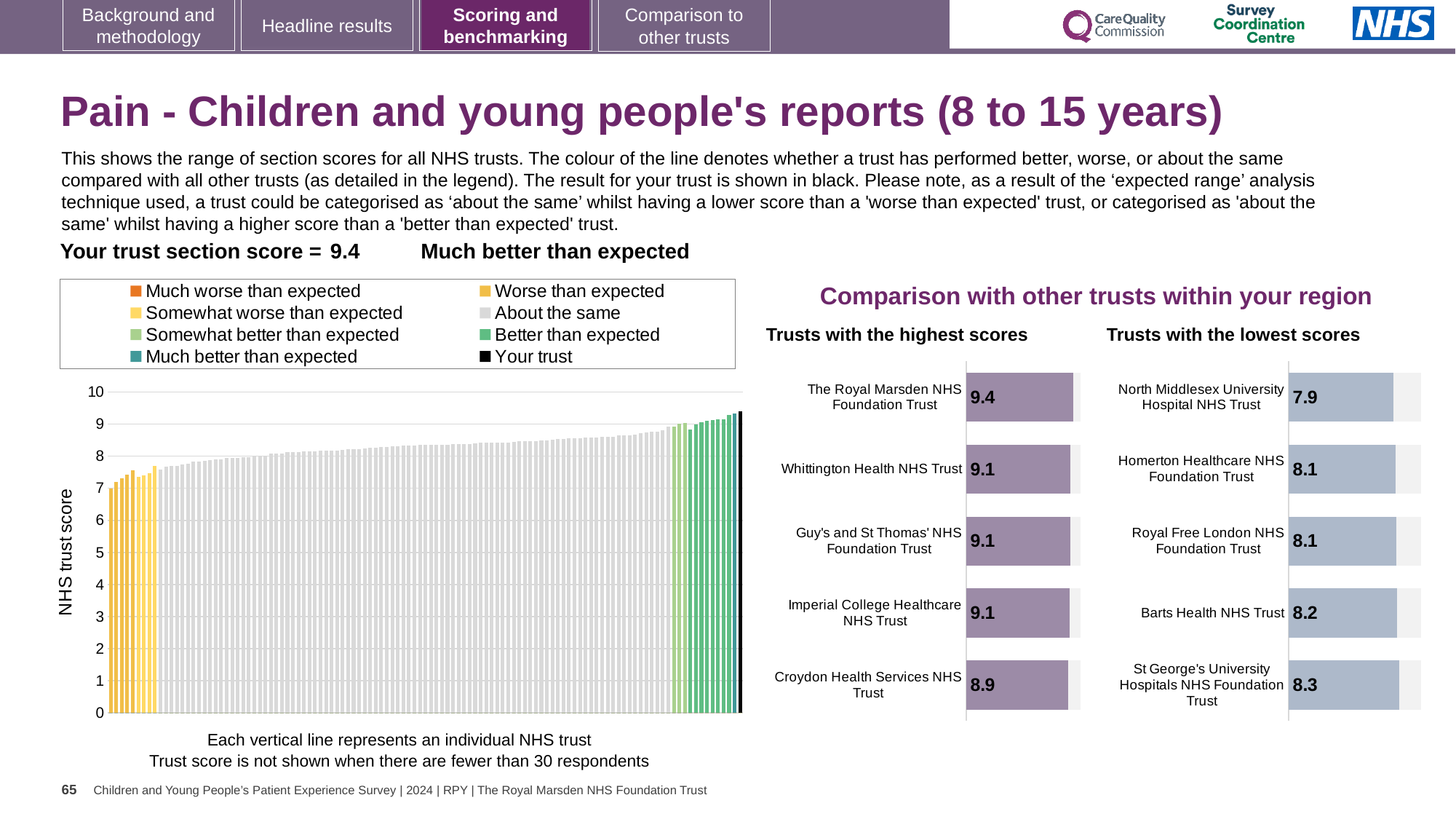
In the 'Trusts with the highest scores' chart, what is the difference between the scores of The Royal Marsden NHS Foundation Trust and Croydon Health Services NHS Trust? 0.5 In the left-hand NHS trust score chart, do the bars rise or fall from left to right? Rise In the left-hand NHS trust score chart, is the value of the leftmost bar greater or less than 5? greater In the 'Trusts with the lowest scores' chart, which trust has the lowest score? North Middlesex University Hospital NHS Trust How many entries does the legend of the left-hand NHS trust score chart list? 8 How many trusts are listed in the 'Trusts with the highest scores' chart? 5 In the 'Trusts with the highest scores' chart, what is the score for The Royal Marsden NHS Foundation Trust? 9.4 What kind of chart is the left-hand chart showing NHS trust scores? Bar chart In the 'Trusts with the lowest scores' chart, what is the score for North Middlesex University Hospital NHS Trust? 7.9 In the 'Trusts with the highest scores' chart, what is the score for Croydon Health Services NHS Trust? 8.9 In the 'Trusts with the lowest scores' chart, which trust has the highest score? St George's University Hospitals NHS Foundation Trust In the 'Trusts with the lowest scores' chart, which has the larger score: Barts Health NHS Trust or Homerton Healthcare NHS Foundation Trust? Barts Health NHS Trust